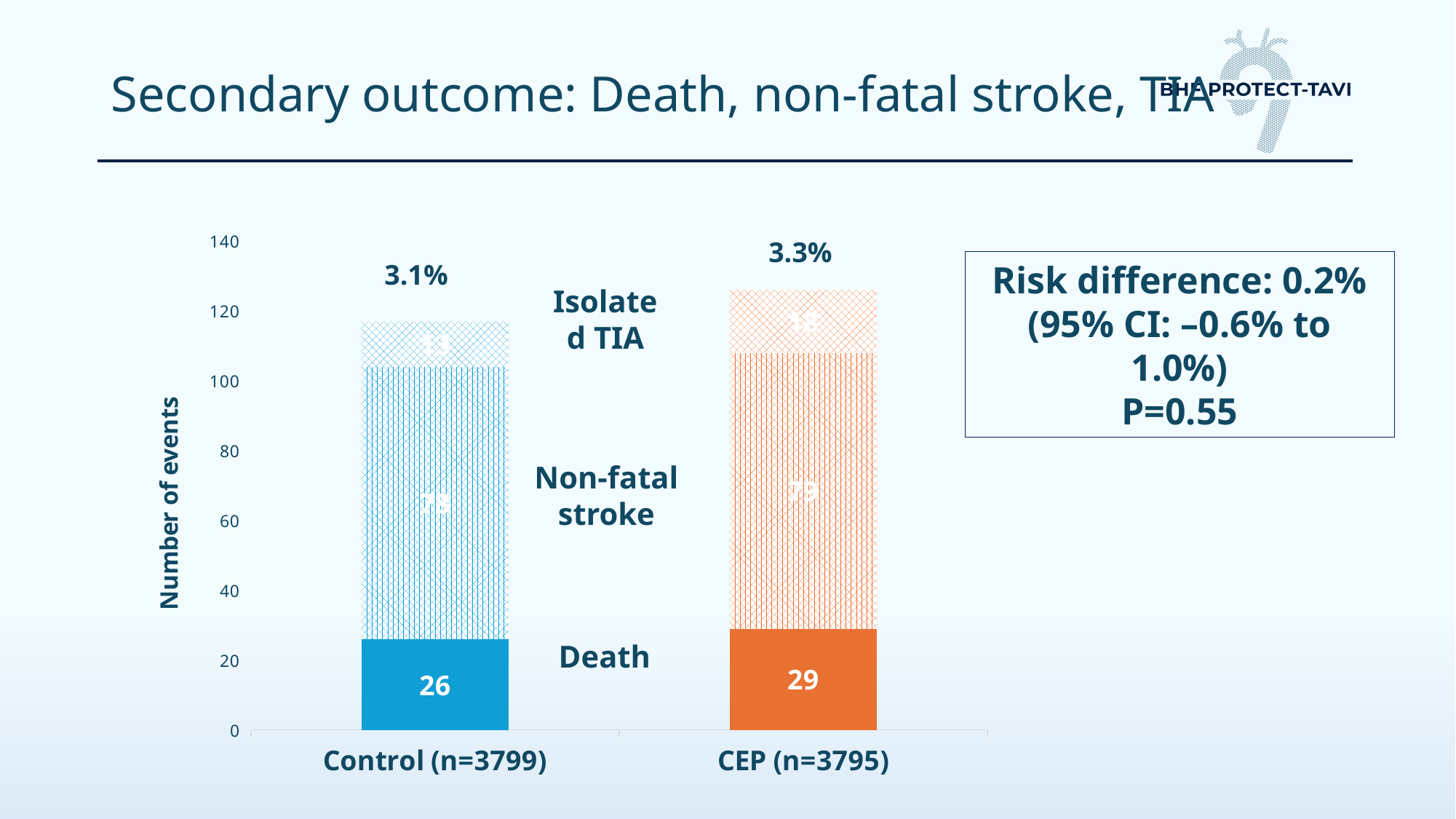
Is the total number of events for the CEP group greater or less than 140? less How many groups (bars) are shown on the x axis? 2 What percentage is printed above the Control (n=3799) bar? 3.1% What kind of chart is shown on the slide? Stacked bar chart Is the total number of events for the Control group greater or less than 100? greater What is the difference in the number of deaths between the CEP and Control groups? 3 Which group's stacked bar reaches a higher total number of events? CEP (n=3795) How many stacked segments (outcome types) make up each bar? 3 How many deaths are shown for the Control (n=3799) group? 26 How many deaths are shown for the CEP (n=3795) group? 29 What percentage is printed above the CEP (n=3795) bar? 3.3% Which group has more deaths, Control or CEP? CEP